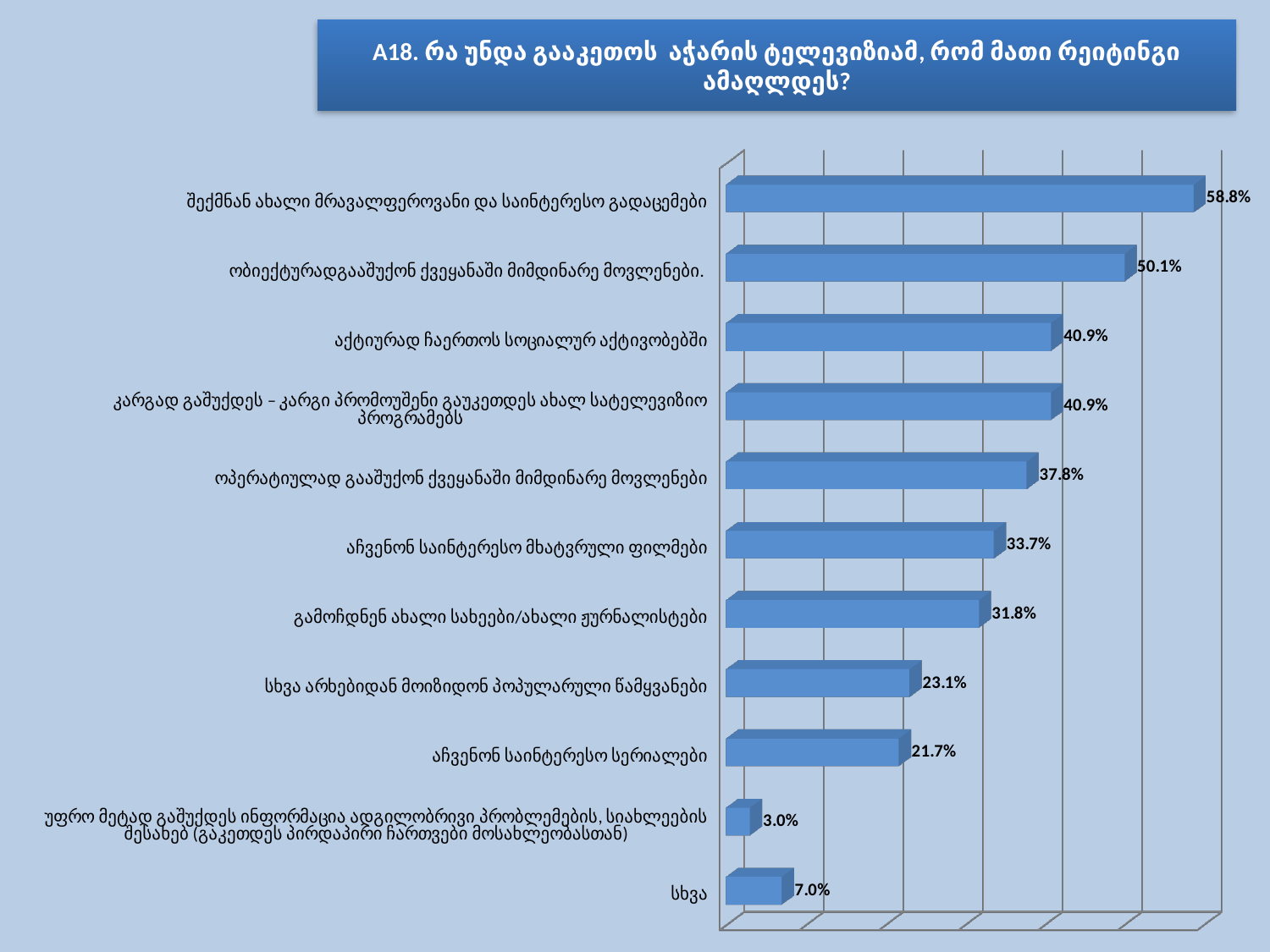
What is the difference between the values for "შექმნან ახალი მრავალფეროვანი და საინტერესო გადაცემები" and "ობიექტურადგააშუქონ ქვეყანაში მიმდინარე მოვლენები."? 8.7% What is the title of the chart on the slide? A18. რა უნდა გააკეთოს აჭარის ტელევიზიამ, რომ მათი რეიტინგი ამაღლდეს? Which category has the lowest value? უფრო მეტად გაშუქდეს ინფორმაცია ადგილობრივი პრობლემების, სიახლეების შესახებ (გაკეთდეს პირდაპირი ჩართვები მოსახლეობასთან) What is the value for "აჩვენონ საინტერესო სერიალები"? 21.7% What is the value for "გამოჩნდნენ ახალი სახეები/ახალი ჟურნალისტები"? 31.8% What type of chart is shown on the slide? bar chart What is the value for "სხვა"? 7.0% Which category has the highest value? შექმნან ახალი მრავალფეროვანი და საინტერესო გადაცემები Which is larger: the value for "სხვა არხებიდან მოიზიდონ პოპულარული წამყვანები" or the value for "აჩვენონ საინტერესო სერიალები"? სხვა არხებიდან მოიზიდონ პოპულარული წამყვანები What is the difference between the values for "აჩვენონ საინტერესო მხატვრული ფილმები" and "სხვა"? 26.7% What is the value for "შექმნან ახალი მრავალფეროვანი და საინტერესო გადაცემები"? 58.8% How many categories are plotted in the chart? 11